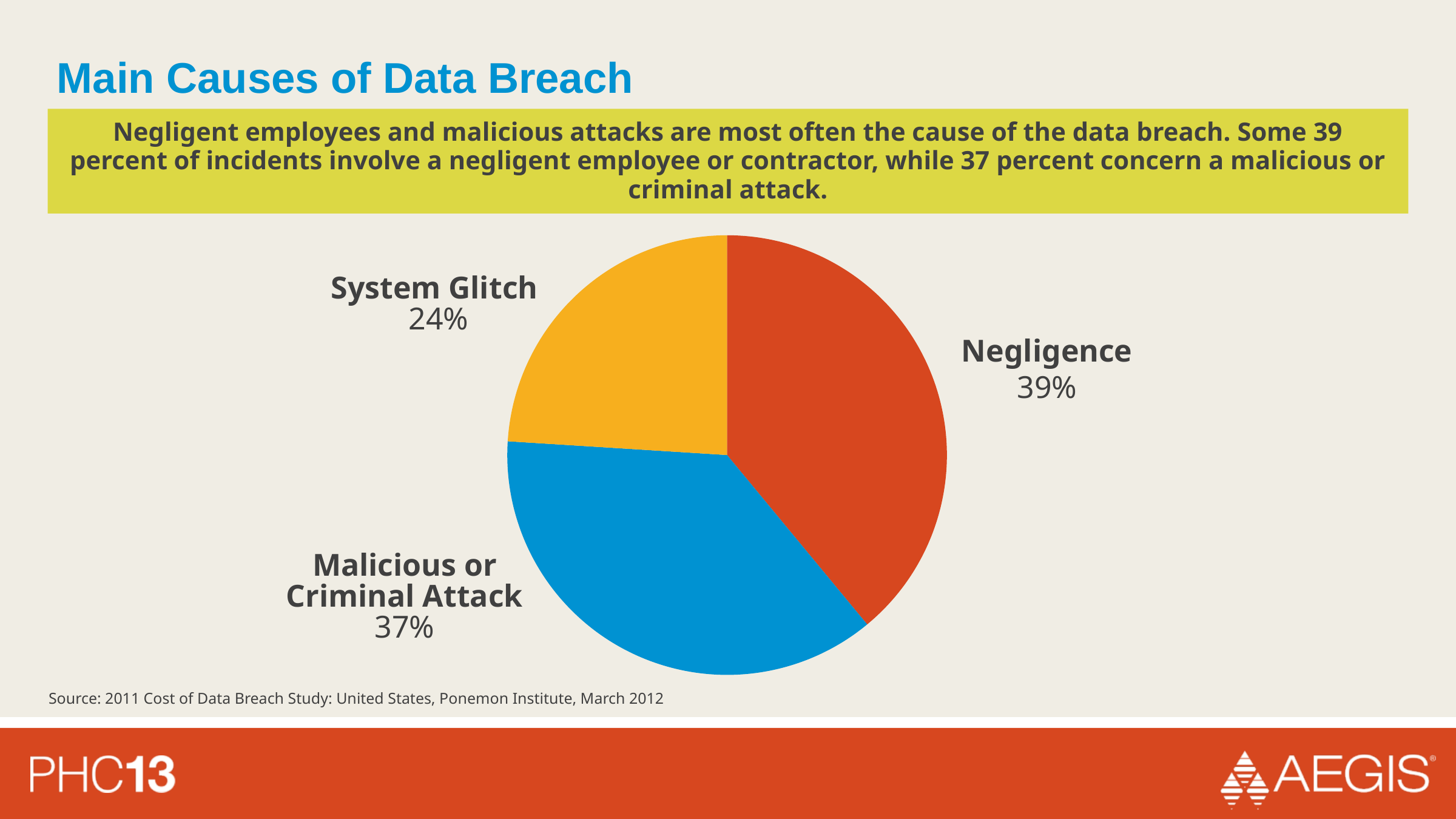
What is the difference in percentage points between Negligence and Malicious or Criminal Attack? 2 What kind of chart is shown on the slide? Pie chart How many slices does the pie chart have? 3 What share of data breaches is attributed to System Glitch? 24% What is the title of the slide containing the pie chart? Main Causes of Data Breach What share of data breaches is attributed to Malicious or Criminal Attack? 37% Which cause of data breach has the largest share in the pie chart? Negligence What is the difference in percentage points between Negligence and System Glitch? 15 Which is larger, the share for Malicious or Criminal Attack or the share for System Glitch? Malicious or Criminal Attack What colour is the Negligence slice of the pie chart? Red What share of data breaches is attributed to Negligence? 39% Which cause of data breach has the smallest share in the pie chart? System Glitch